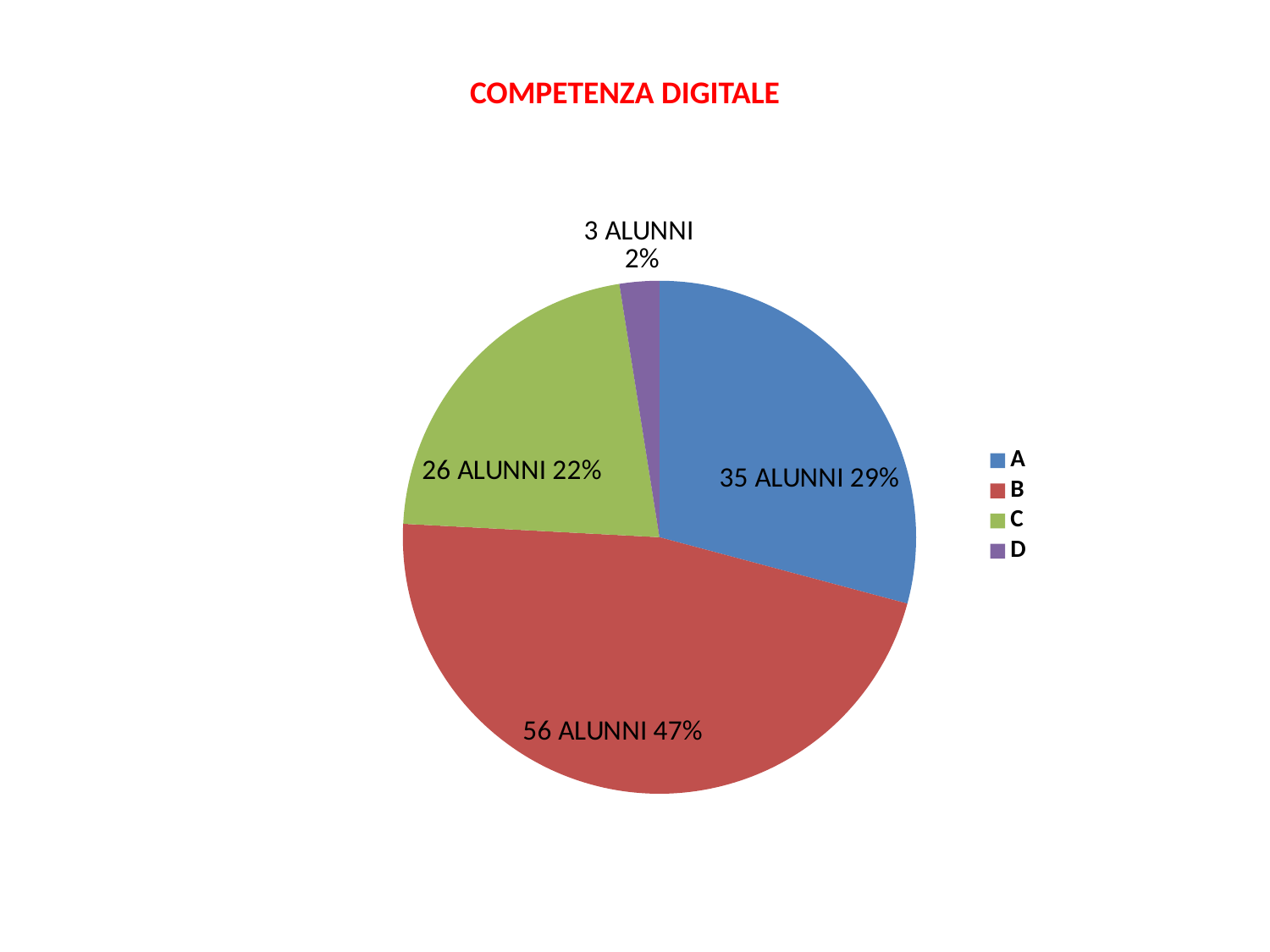
Which category has the largest slice? B What is the title of the chart? COMPETENZA DIGITALE How many alunni are in category A? 35 ALUNNI What kind of chart is shown on the slide? pie chart What percentage share does category B have? 47% How many slices does the pie chart have? 4 How many entries does the legend list? 4 What is the difference in number of alunni between category B and category A? 21 Which category has more alunni, A or C? A How many alunni are in category C? 26 ALUNNI Which category has the smallest slice? D What percentage share does category D have? 2%